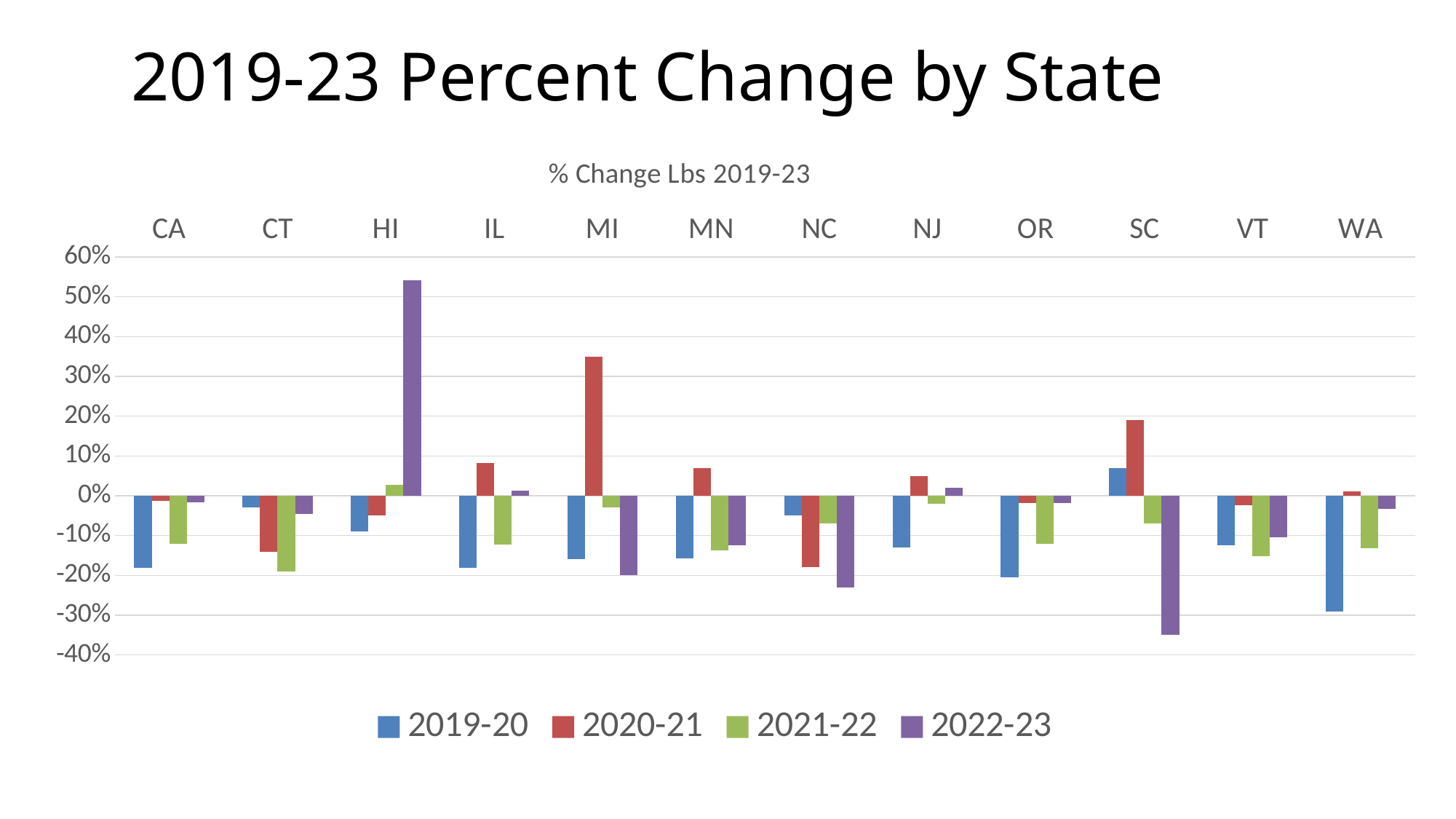
How many series does the legend list? 4 What is the title printed above the chart area? % Change Lbs 2019-23 Which state has the highest 2019-20 value? SC Is the 2019-20 value for WA greater or less than -20%? less Which state and series has the lowest bar on the chart? SC, 2022-23 How many states are shown along the x axis? 12 Is the 2020-21 value for MI greater or less than 30%? greater Is the 2022-23 value for HI greater or less than 50%? greater Which state and series has the highest bar on the chart? HI, 2022-23 Which has the lower 2019-20 value, CA or WA? WA What kind of chart is shown on the slide? Bar chart